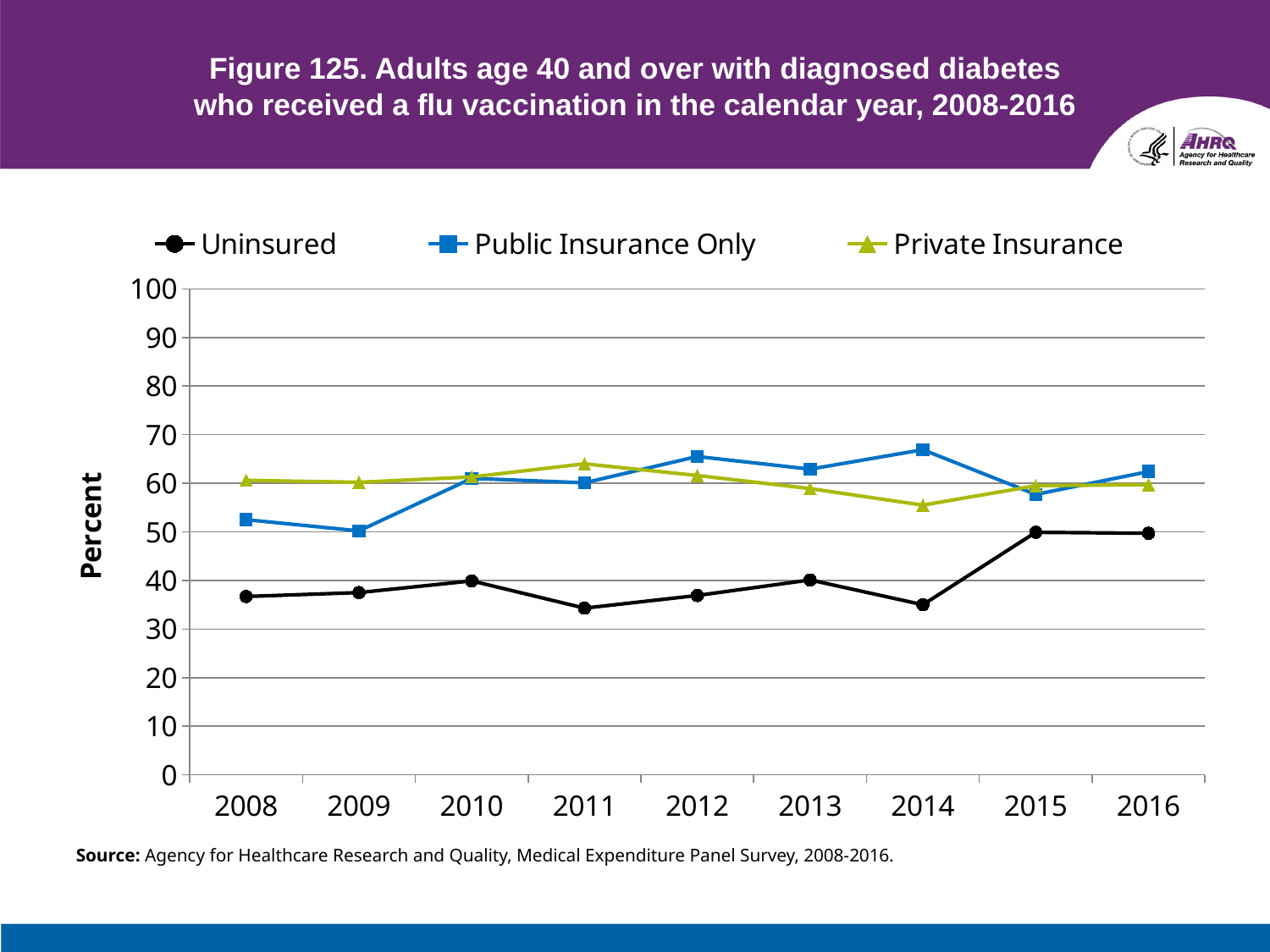
How many series does the legend list? 3 In 2008, which is larger: Uninsured or Private Insurance? Private Insurance Is the value for Uninsured in 2015 greater or less than 40? greater What is the label on the y axis? Percent How many years are plotted along the x axis? 9 Is the value for Public Insurance Only in 2014 greater or less than 60? greater In which year is the Private Insurance value lowest? 2014 Does the Uninsured line rise or fall from 2014 to 2015? rise What kind of chart is shown on the slide? line chart Is the value for Uninsured in 2008 greater or less than 40? less In 2014, which is larger: Public Insurance Only or Private Insurance? Public Insurance Only In which year is the Public Insurance Only value highest? 2014